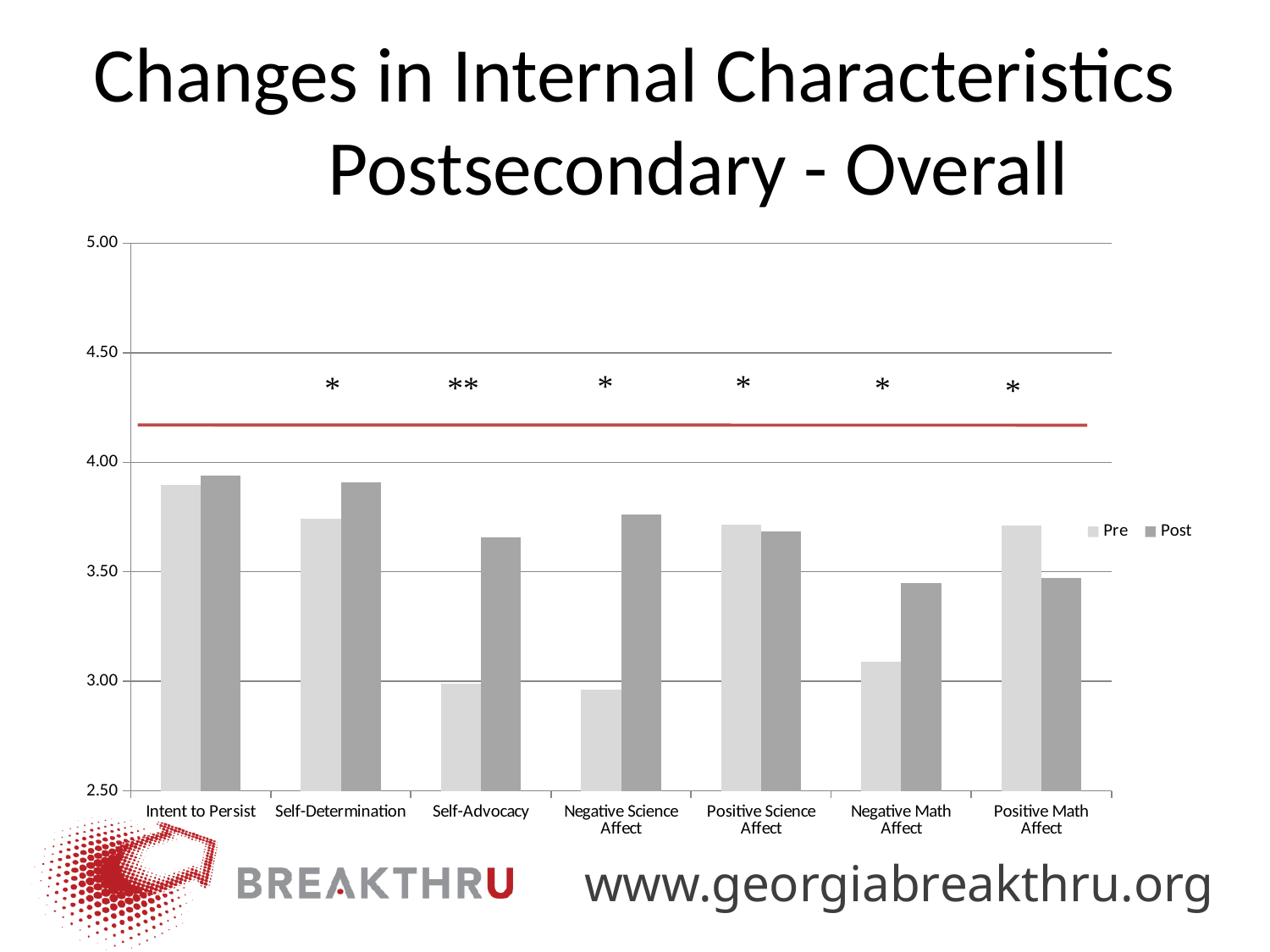
What are the two series named in the chart's legend? Pre and Post Is the Post value for Intent to Persist greater or less than 4.00? less How many categories are shown along the x axis of the chart? 7 For Positive Math Affect, which is larger, the Pre value or the Post value? Pre Is the Pre value for Negative Math Affect greater or less than 3.50? less How many series does the chart's legend list? 2 For Negative Math Affect, which is larger, the Pre value or the Post value? Post Is the Post value for Negative Science Affect greater or less than 3.50? greater Which category has the highest Pre value? Intent to Persist What kind of chart is shown on the slide? bar chart For Self-Advocacy, which is larger, the Pre value or the Post value? Post